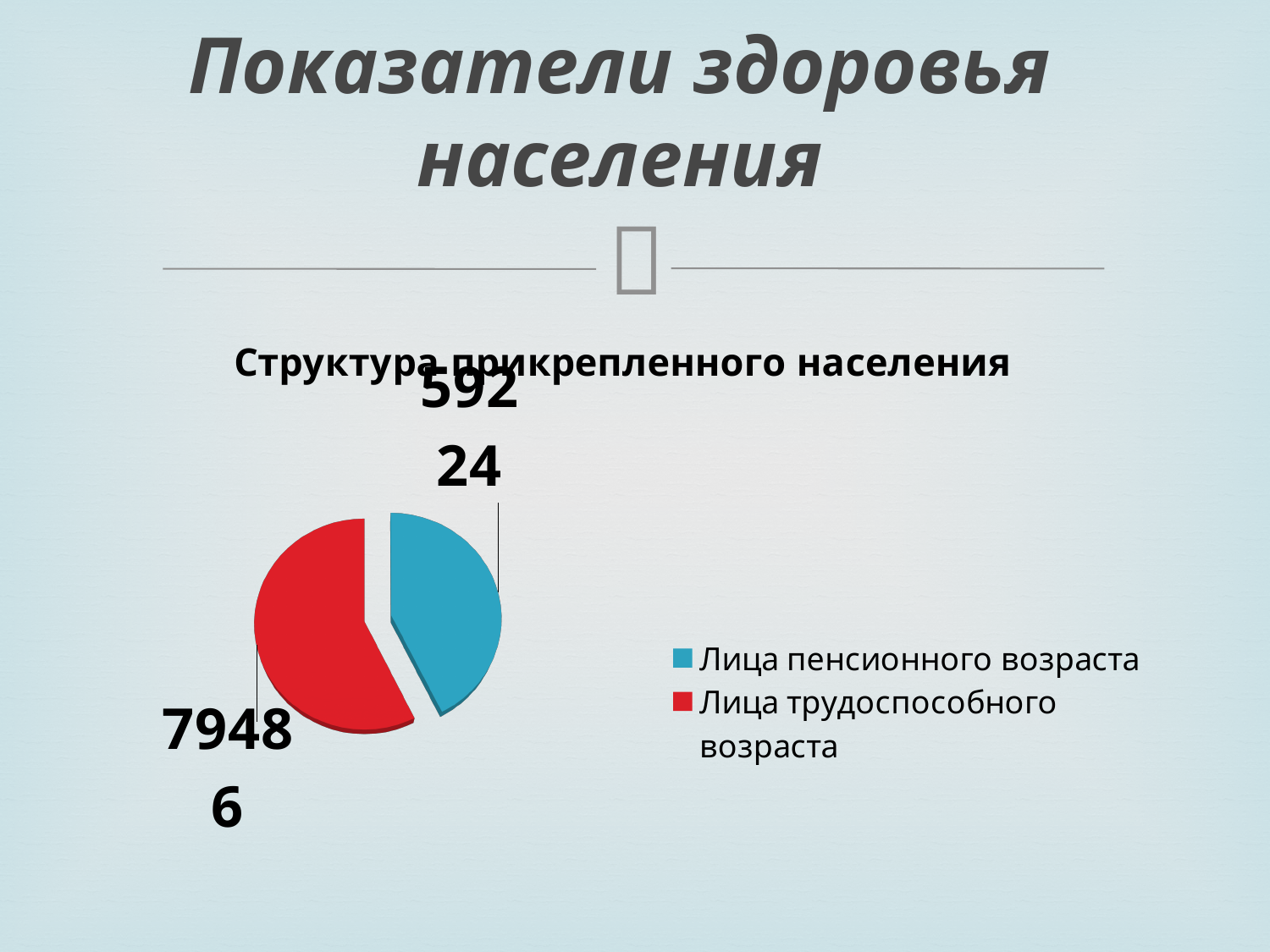
How many entries does the legend list? 2 What colour is the slice for Лица пенсионного возраста? blue How many slices does the pie chart have? 2 What type of chart is shown on the slide? pie chart What is the difference between the values for Лица трудоспособного возраста and Лица пенсионного возраста? 20262 What is the value for Лица трудоспособного возраста? 79486 What is the value for Лица пенсионного возраста? 59224 Which is larger: Лица пенсионного возраста or Лица трудоспособного возраста? Лица трудоспособного возраста What is the title of the chart? Структура прикрепленного населения Which category has the largest slice? Лица трудоспособного возраста Which category has the smallest slice? Лица пенсионного возраста What is the total of the two slices in the pie chart? 138710